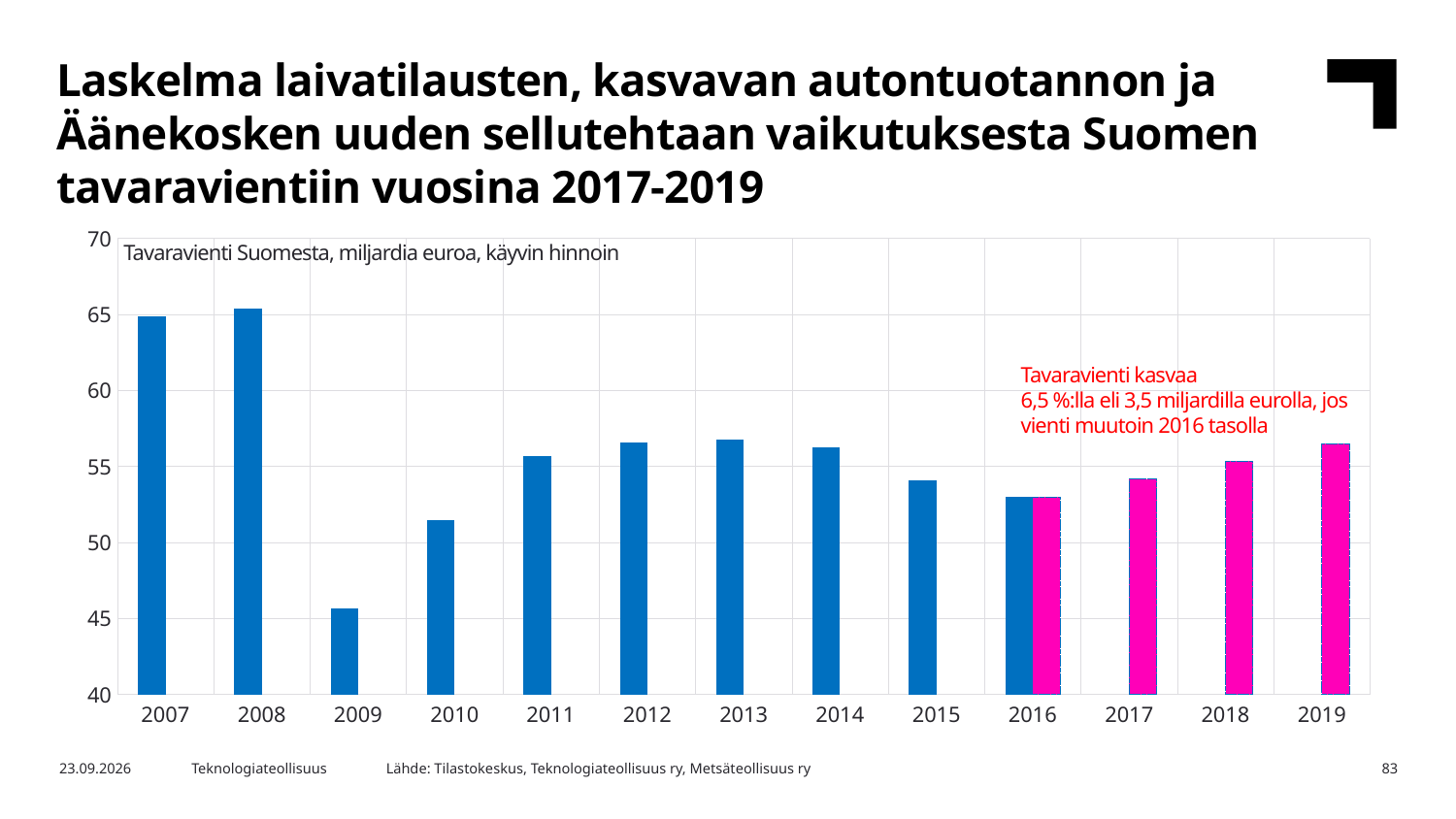
Is the value for 2009 greater or less than 50? less Which is larger, the value for 2007 or the value for 2009? 2007 Is the value for 2015 greater or less than 55? less What colour are the bars for 2017, 2018 and 2019? magenta (pink) Is the value for 2007 greater or less than 60? greater Which is larger, the value for 2018 or the value for 2017? 2018 What kind of chart is shown on the slide? bar chart Which year has the lowest value in the chart? 2009 Do the values rise or fall from 2016 to 2019? rise How many years are shown on the x axis of the chart? 13